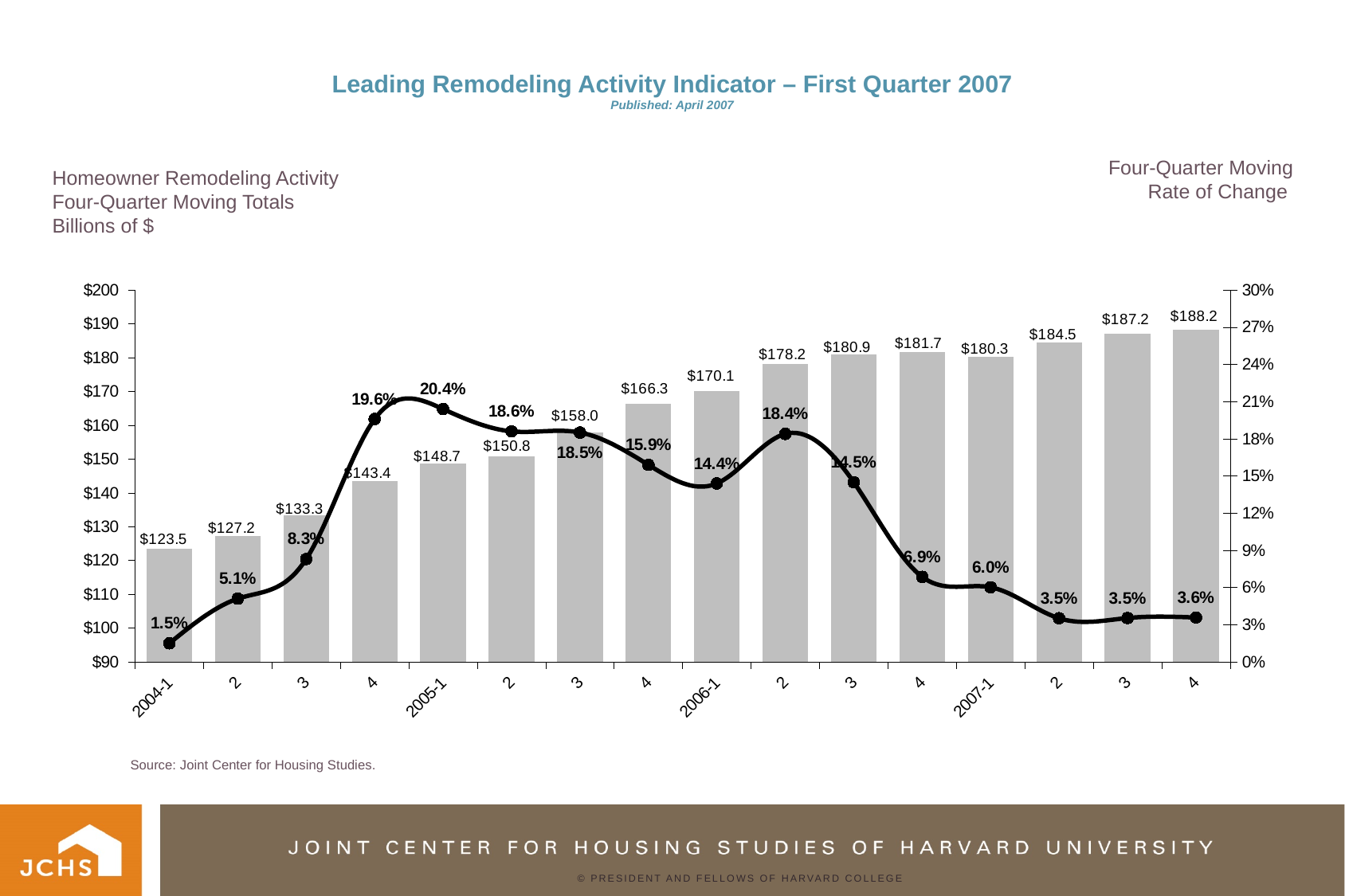
What is the four-quarter moving total for 2006-1? $170.1 Which quarter has the highest four-quarter moving total? 2007-4 Which quarter has the lowest four-quarter moving rate of change? 2004-1 How many quarters are plotted on the chart? 16 Which is larger, the rate of change for 2004-4 or for 2006-2? 2004-4 What kind of chart is this? Combined bar and line chart What is the four-quarter moving rate of change for 2007-1? 6.0% What is the title of the chart? Leading Remodeling Activity Indicator – First Quarter 2007 What is the difference between the four-quarter moving totals for 2007-4 and 2004-1? $64.7 Do the four-quarter moving totals generally rise or fall from 2004-1 to 2007-4? Rise What is the four-quarter moving rate of change for 2005-1? 20.4% What is the four-quarter moving total for 2004-1? $123.5